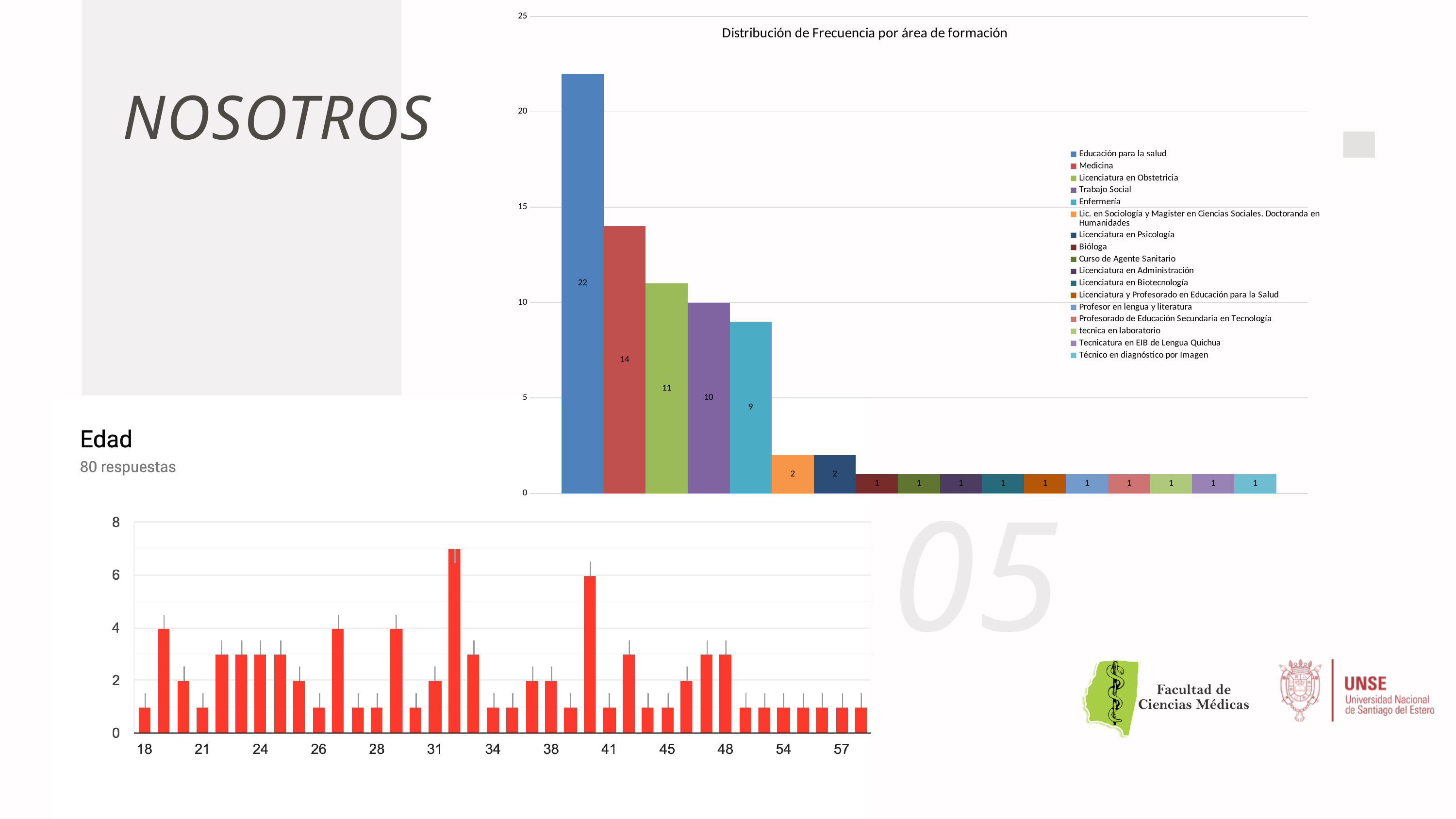
In the chart 'Distribución de Frecuencia por área de formación', what colour is the bar for Educación para la salud? blue In the chart 'Distribución de Frecuencia por área de formación', what is the value for Medicina? 14 In the chart 'Distribución de Frecuencia por área de formación', what is the difference between Educación para la salud and Medicina? 8 What kind of chart is 'Distribución de Frecuencia por área de formación'? bar chart In the chart 'Distribución de Frecuencia por área de formación', how many entries does the legend list? 17 In the chart 'Distribución de Frecuencia por área de formación', which is larger: Licenciatura en Obstetricia or Trabajo Social? Licenciatura en Obstetricia In the chart 'Distribución de Frecuencia por área de formación', how many categories have a value of 1? 10 In the 'Edad' chart, is the value for age 18 greater or less than 2? less In the chart 'Distribución de Frecuencia por área de formación', what is the value for Educación para la salud? 22 In the chart 'Distribución de Frecuencia por área de formación', what is the value for Enfermería? 9 In the 'Edad' chart, is the value for age 24 greater or less than 2? greater In the chart 'Distribución de Frecuencia por área de formación', which category has the highest value? Educación para la salud